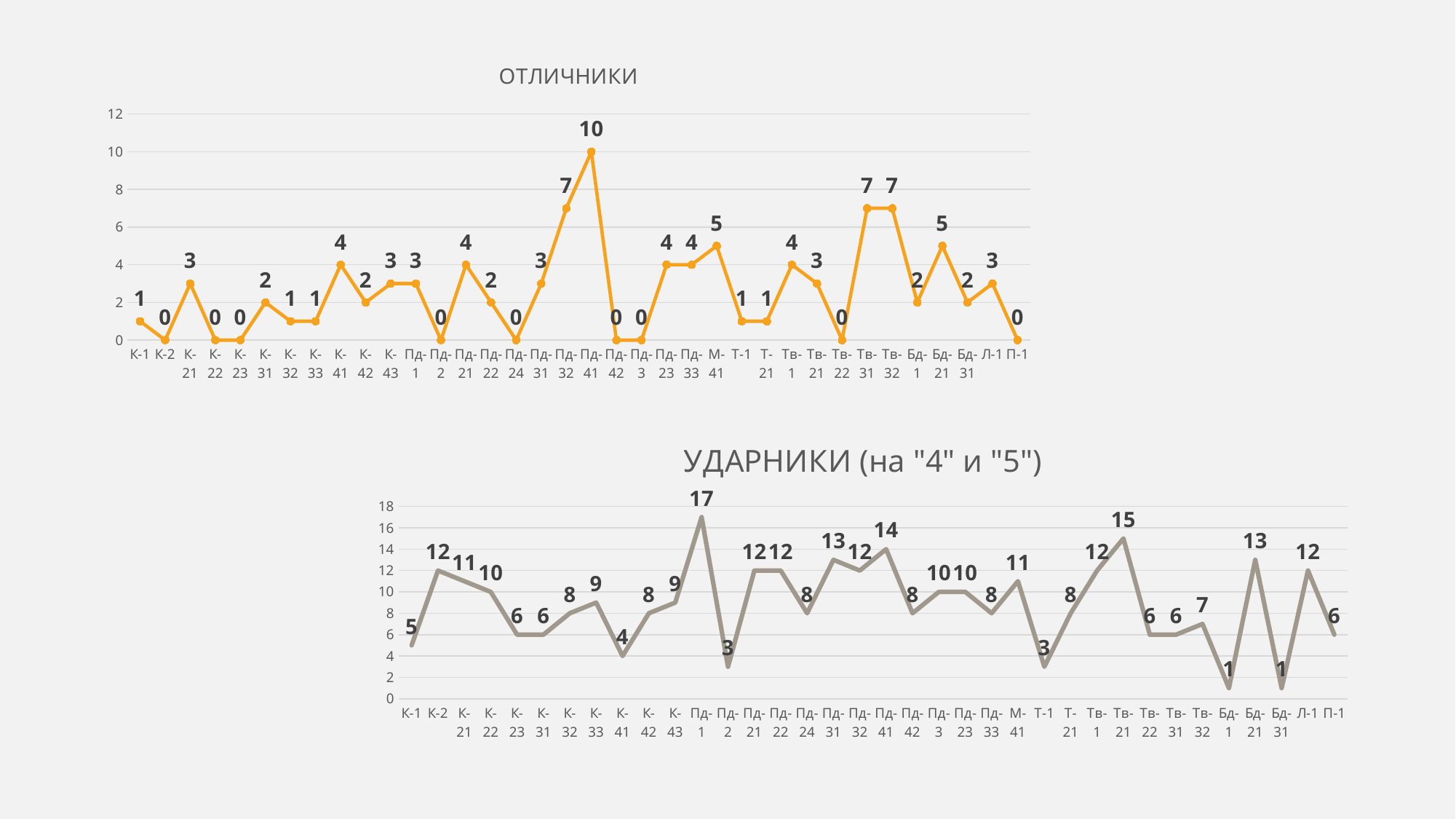
In the ОТЛИЧНИКИ chart, which category has the highest value? Пд-41 In the УДАРНИКИ (на "4" и "5") chart, what is the value for Тв-21? 15 In the УДАРНИКИ (на "4" и "5") chart, which is larger, the value for К-2 or the value for К-22? К-2 In the ОТЛИЧНИКИ chart, what is the value for Пд-41? 10 In the УДАРНИКИ (на "4" и "5") chart, what is the value for Пд-1? 17 In the УДАРНИКИ (на "4" и "5") chart, which category has the highest value? Пд-1 In the ОТЛИЧНИКИ chart, what is the difference between the values for Пд-41 and Пд-32? 3 How many categories are shown on the x axis of the ОТЛИЧНИКИ chart? 36 In the ОТЛИЧНИКИ chart, which is larger, the value for Тв-31 or the value for Бд-21? Тв-31 In the УДАРНИКИ (на "4" и "5") chart, what is the difference between the values for Пд-1 and Пд-2? 14 What type of chart is the УДАРНИКИ (на "4" и "5") chart? Line chart In the ОТЛИЧНИКИ chart, what is the value for М-41? 5